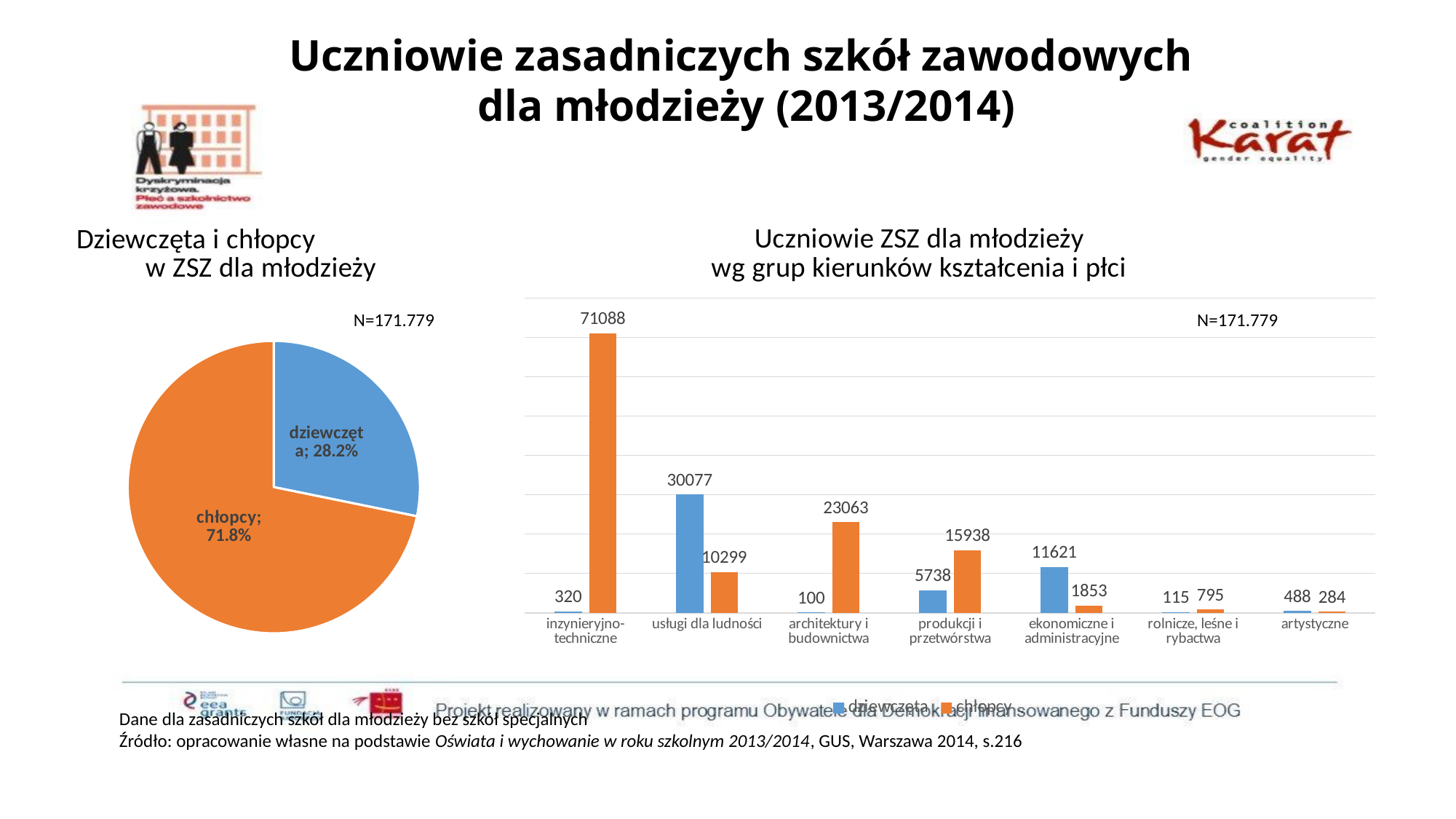
In the bar chart 'Uczniowie ZSZ dla młodzieży wg grup kierunków kształcenia i płci', which is larger in ekonomiczne i administracyjne: dziewczęta or chłopcy? dziewczęta In the pie chart 'Dziewczęta i chłopcy w ZSZ dla młodzieży', what share of the pie is dziewczęta? 28.2% In the bar chart 'Uczniowie ZSZ dla młodzieży wg grup kierunków kształcenia i płci', which category has the highest value for chłopcy? inzynieryjno-techniczne How many categories are shown on the x axis of the bar chart 'Uczniowie ZSZ dla młodzieży wg grup kierunków kształcenia i płci'? 7 What kind of chart is 'Uczniowie ZSZ dla młodzieży wg grup kierunków kształcenia i płci'? Bar chart In the bar chart 'Uczniowie ZSZ dla młodzieży wg grup kierunków kształcenia i płci', what is the value for dziewczęta in usługi dla ludności? 30077 In the bar chart 'Uczniowie ZSZ dla młodzieży wg grup kierunków kształcenia i płci', what is the value for chłopcy in inzynieryjno-techniczne? 71088 In the bar chart 'Uczniowie ZSZ dla młodzieży wg grup kierunków kształcenia i płci', which category has the lowest value for dziewczęta? architektury i budownictwa In the pie chart 'Dziewczęta i chłopcy w ZSZ dla młodzieży', what share of the pie is chłopcy? 71.8% In the bar chart 'Uczniowie ZSZ dla młodzieży wg grup kierunków kształcenia i płci', what is the difference between chłopcy and dziewczęta in produkcji i przetwórstwa? 10200 In the bar chart 'Uczniowie ZSZ dla młodzieży wg grup kierunków kształcenia i płci', what is the value for dziewczęta in architektury i budownictwa? 100 What kind of chart is the chart on the left of the slide? Pie chart